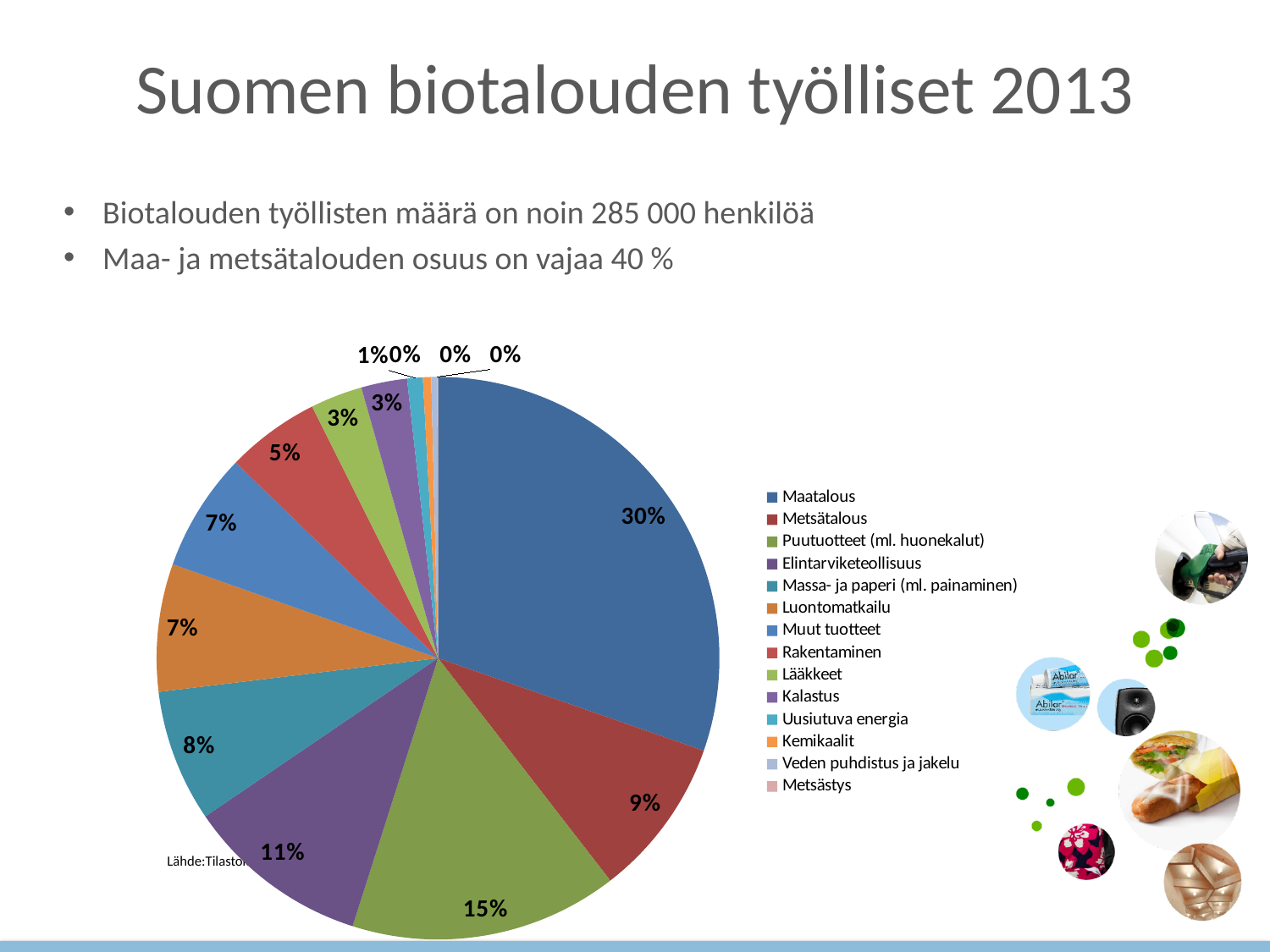
What share of the pie does Rakentaminen have? 5% What type of chart is shown on the slide? pie chart What share of the pie does Puutuotteet (ml. huonekalut) have? 15% How many categories does the legend list? 14 Which has a larger share, Metsätalous or Massa- ja paperi (ml. painaminen)? Metsätalous What share of the pie does Maatalous have? 30% What share of the pie does Elintarviketeollisuus have? 11% What is the title of the slide containing the pie chart? Suomen biotalouden työlliset 2013 What is the difference between the shares of Maatalous and Puutuotteet (ml. huonekalut)? 15% What share of the pie does Uusiutuva energia have? 1% What share of the pie does Metsätalous have? 9% Which category has the largest slice of the pie? Maatalous